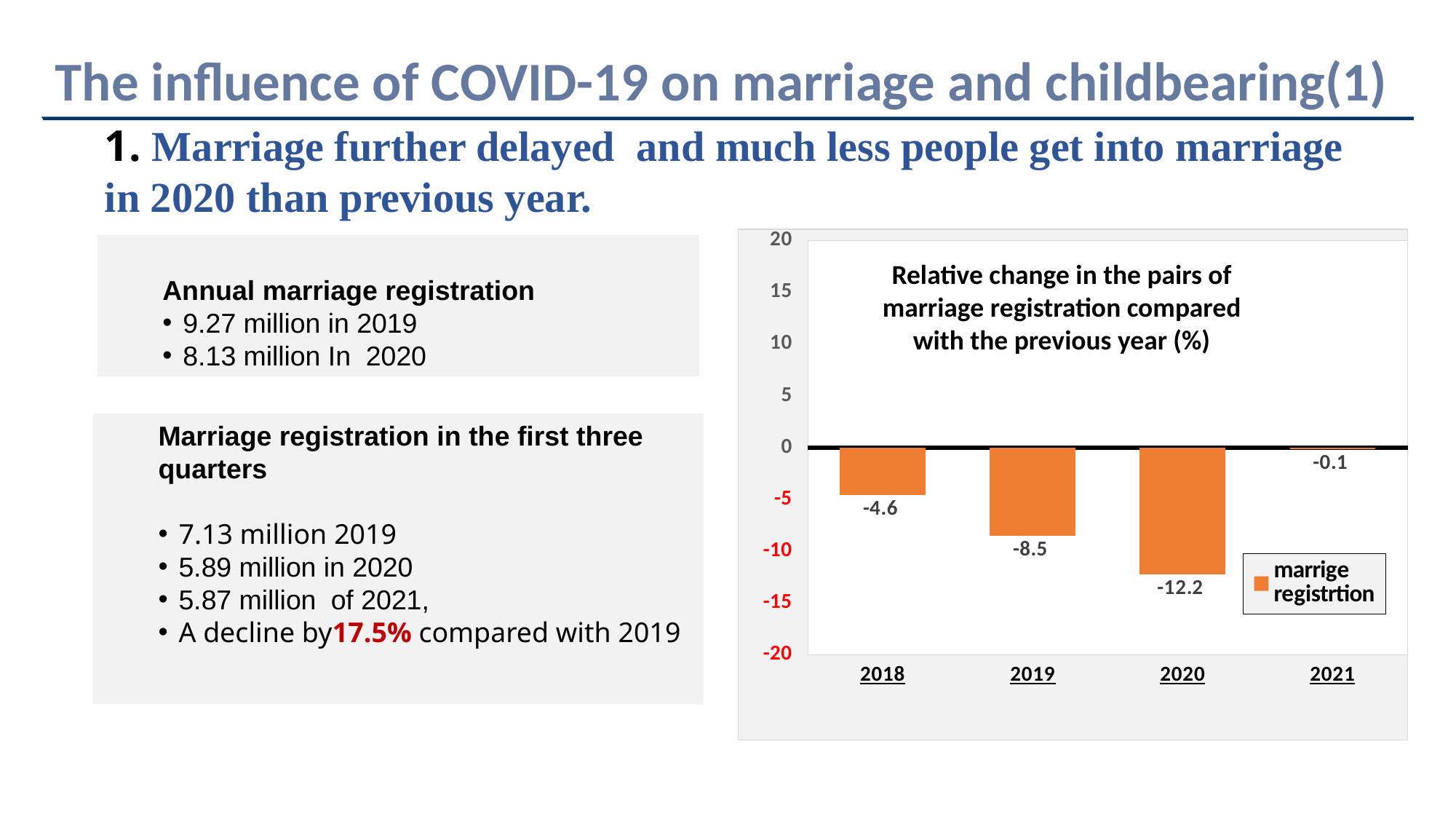
What is the title of the chart? Relative change in the pairs of marriage registration compared with the previous year (%) Which year shows the lowest (most negative) relative change in marriage registration? 2020 How many years are shown on the x axis of the chart? 4 How many series does the chart legend list? 1 What kind of chart is shown on the slide? bar chart Is the value for 2020 greater or less than -10? less Which year has a larger relative change value, 2018 or 2019? 2018 Which year shows the highest relative change in marriage registration? 2021 What is the relative change in marriage registration pairs for 2020? -12.2 What is the difference between the 2019 and 2020 values? 3.7 What is the relative change in marriage registration pairs for 2018? -4.6 What is the relative change in marriage registration pairs for 2021? -0.1